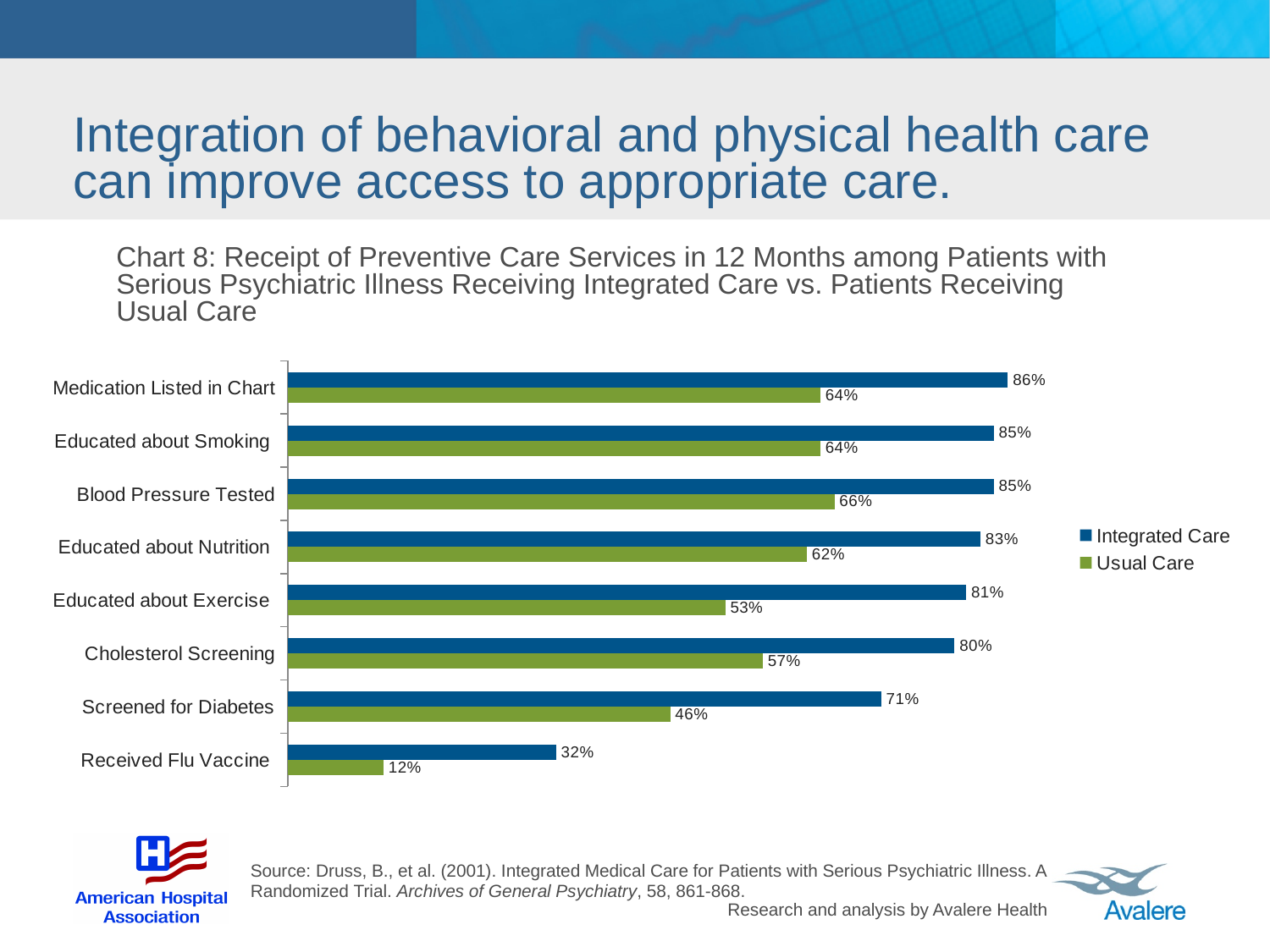
How many categories are shown on the chart? 8 Which category has the highest Integrated Care value? Medication Listed in Chart What is the Integrated Care value for Screened for Diabetes? 71% What is the Usual Care value for Medication Listed in Chart? 64% Which series is shown in green in the legend? Usual Care What is the difference between the Integrated Care and Usual Care values for Received Flu Vaccine? 20% Which category has the lowest Usual Care value? Received Flu Vaccine How many series does the legend list? 2 What is the Usual Care value for Educated about Exercise? 53% Which is larger: the Usual Care value for Blood Pressure Tested or the Usual Care value for Cholesterol Screening? Blood Pressure Tested What kind of chart is shown on the slide? Bar chart What is the difference between the Integrated Care and Usual Care values for Screened for Diabetes? 25%